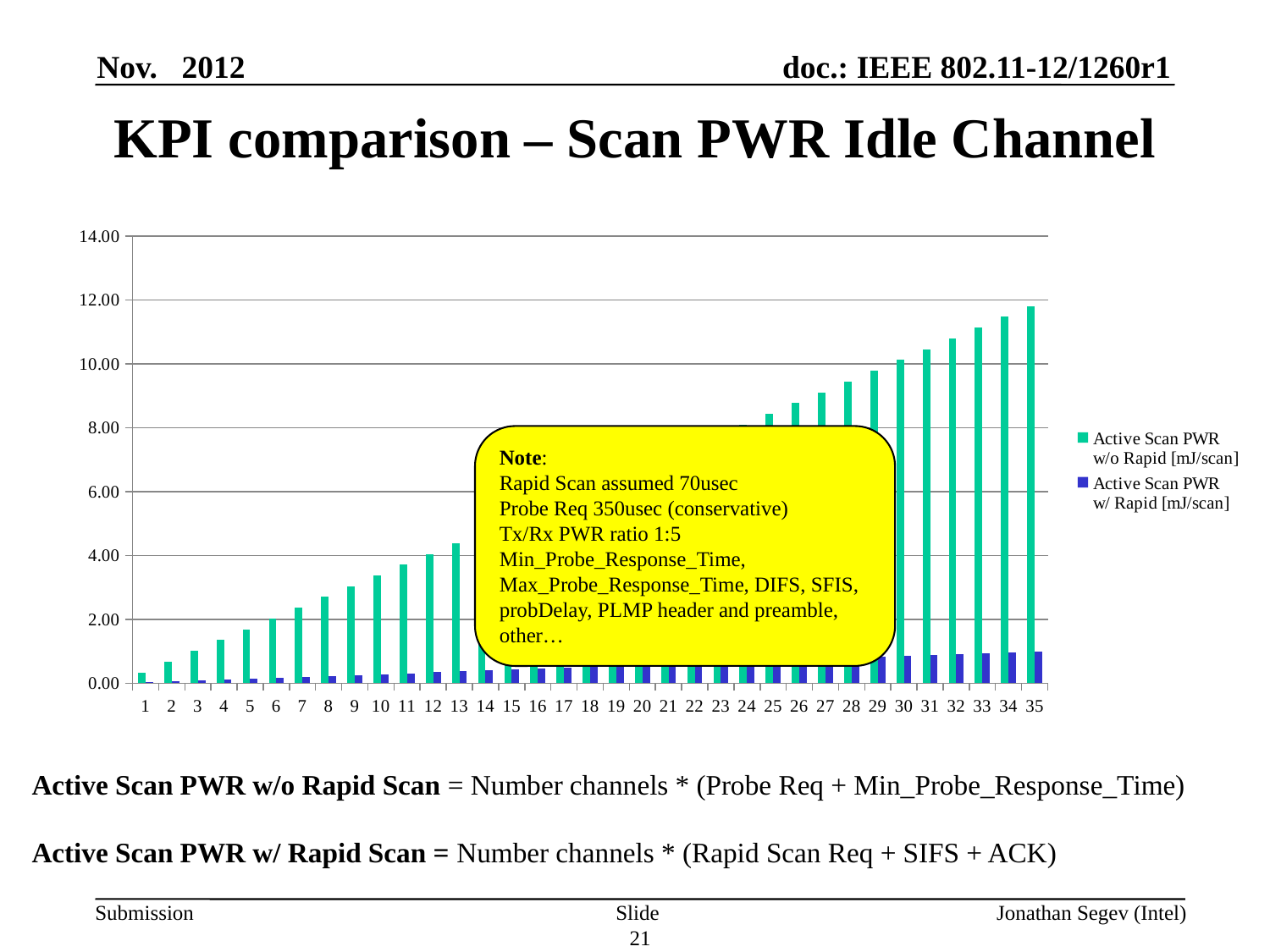
At category 35, which series has the larger value: Active Scan PWR w/o Rapid [mJ/scan] or Active Scan PWR w/ Rapid [mJ/scan]? Active Scan PWR w/o Rapid [mJ/scan] Is the value for Active Scan PWR w/o Rapid [mJ/scan] at category 35 greater or less than 10.00? greater Is the value for Active Scan PWR w/ Rapid [mJ/scan] at category 35 greater or less than 2.00? less How many categories are shown along the x axis? 35 Do the values for Active Scan PWR w/o Rapid [mJ/scan] rise or fall as the category number increases along the x axis? rise What kind of chart is shown on the slide? bar chart What is the highest value shown on the y axis? 14.00 What colour are the bars for Active Scan PWR w/ Rapid [mJ/scan]? blue Which category has the lowest value for Active Scan PWR w/o Rapid [mJ/scan]? 1 Which category has the highest value for Active Scan PWR w/o Rapid [mJ/scan]? 35 How many series does the legend list? 2 Is the value for Active Scan PWR w/o Rapid [mJ/scan] at category 10 greater or less than 4.00? less